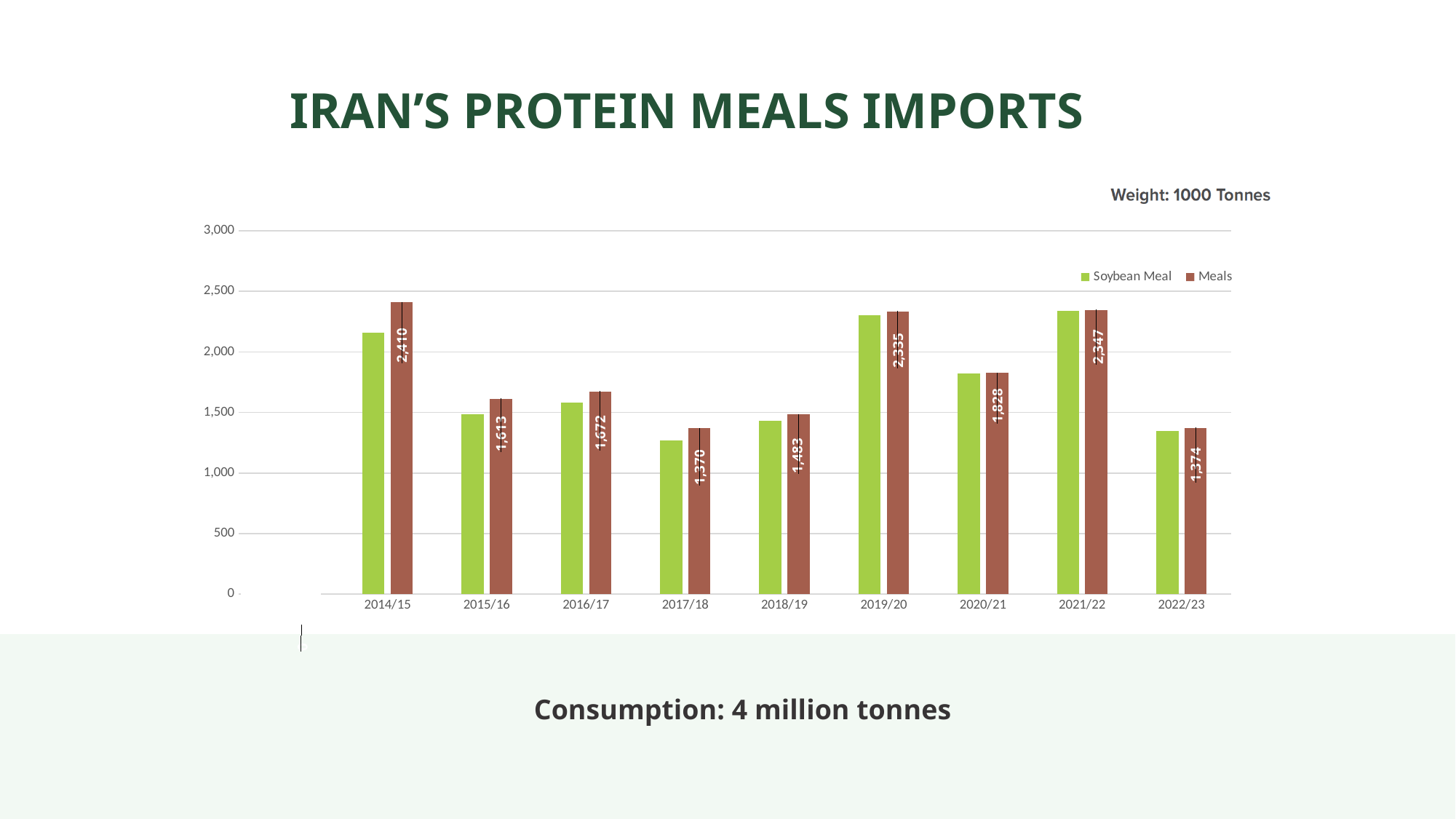
Is the Soybean Meal value for 2014/15 greater or less than 2,000? greater What is the difference between the Meals value in 2014/15 and in 2022/23? 1,036 In which year is the Meals value highest? 2014/15 Is the Soybean Meal value for 2017/18 greater or less than 1,500? less What is the value for Meals in 2022/23? 1,374 What is the value for Meals in 2020/21? 1,828 Which is larger, the Meals value in 2019/20 or in 2020/21? 2019/20 What is the value for Meals in 2014/15? 2,410 In which year is the Meals value lowest? 2017/18 What kind of chart is shown on the slide? Bar chart How many series does the legend list? 2 How many years are shown on the x axis? 9